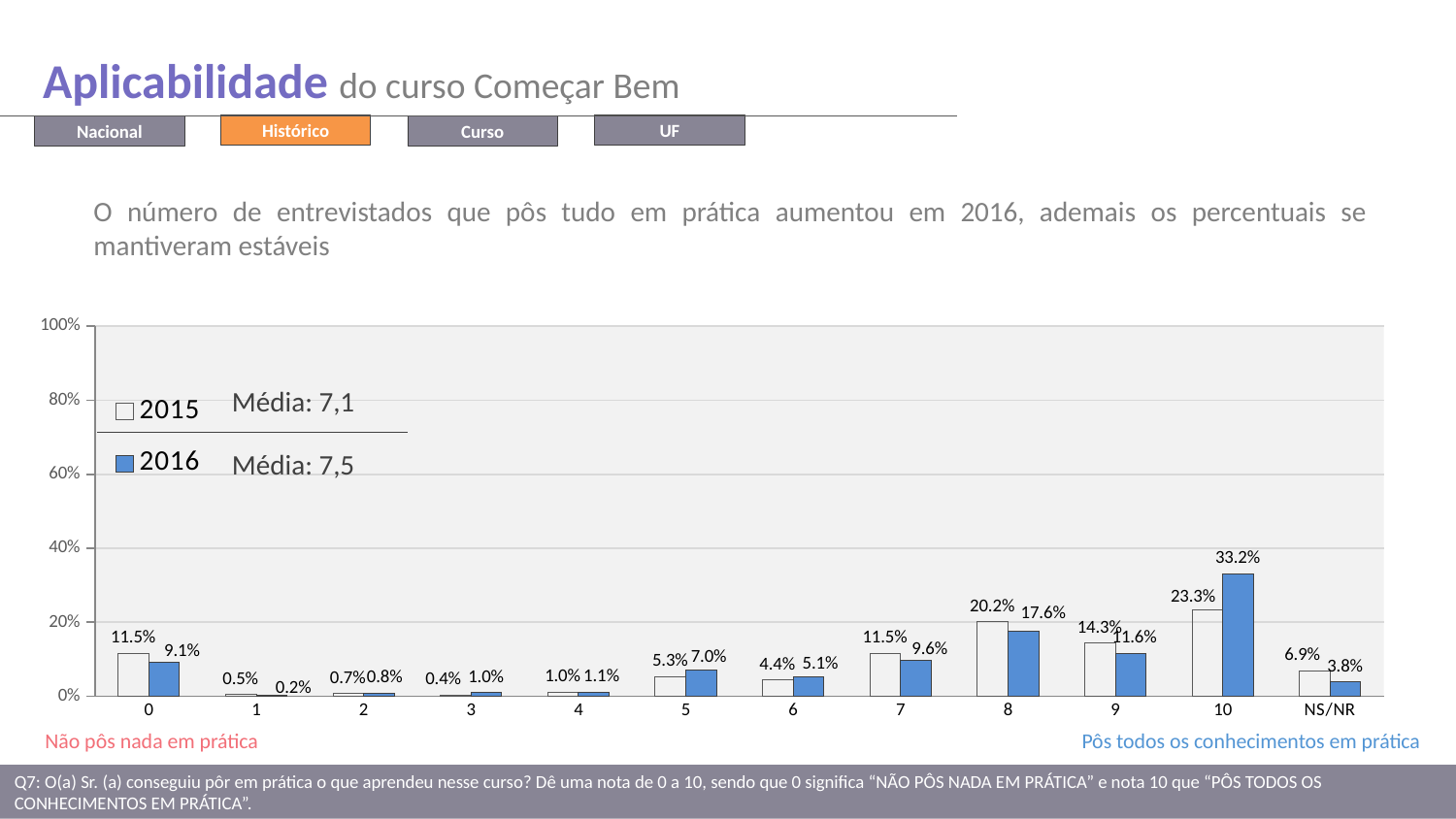
What kind of chart is shown on the slide? bar chart What is the value for NS/NR in the 2016 series? 3.8% What is the mean (Média) shown for 2016? 7,5 Which category has the lowest value in the 2016 series? 1 How many categories are shown on the x axis? 12 What is the value for category 10 in the 2016 series? 33.2% Which category has the highest value in the 2016 series? 10 What is the value for category 8 in the 2015 series? 20.2% How many series does the legend list? 2 What is the difference between the 2016 and 2015 values for category 10? 9.9% Is the 2016 value for category 10 greater or less than 20%? greater For category 9, which series has the larger value, 2015 or 2016? 2015